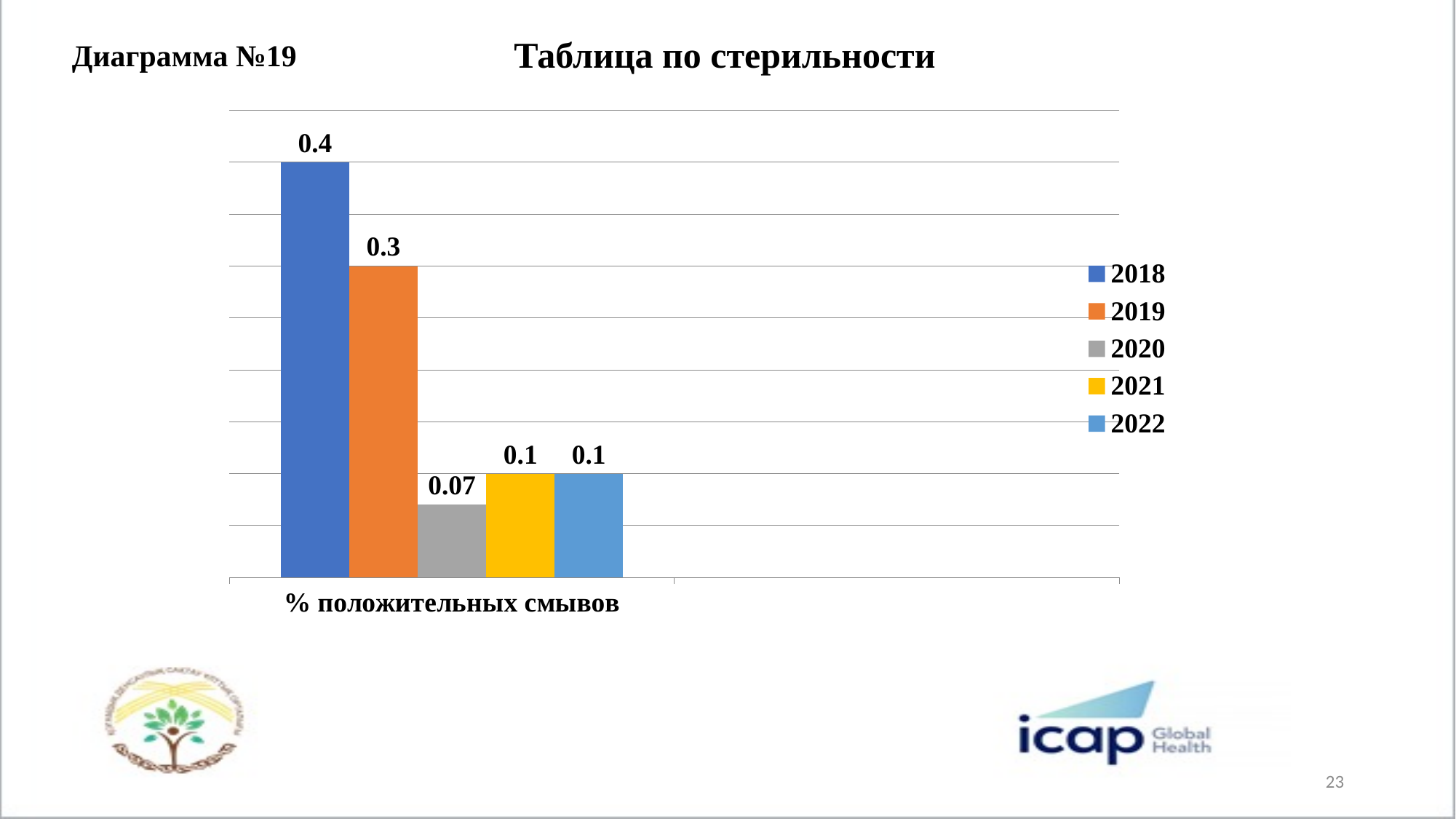
What is the value for 2020 in the chart? 0.07 Which year has the lowest value in the chart? 2020 How many series does the legend list? 5 What is the value for 2018 in the chart? 0.4 Which is larger, the value for 2019 or the value for 2022? 2019 Which year has the highest value in the chart? 2018 What is the difference between the values for 2018 and 2019? 0.1 What kind of chart is shown on the slide? Bar chart What is the difference between the values for 2021 and 2020? 0.03 What is the title of the chart? Таблица по стерильности What is the value for 2019 in the chart? 0.3 What is the category label shown on the x axis of the chart? % положительных смывов